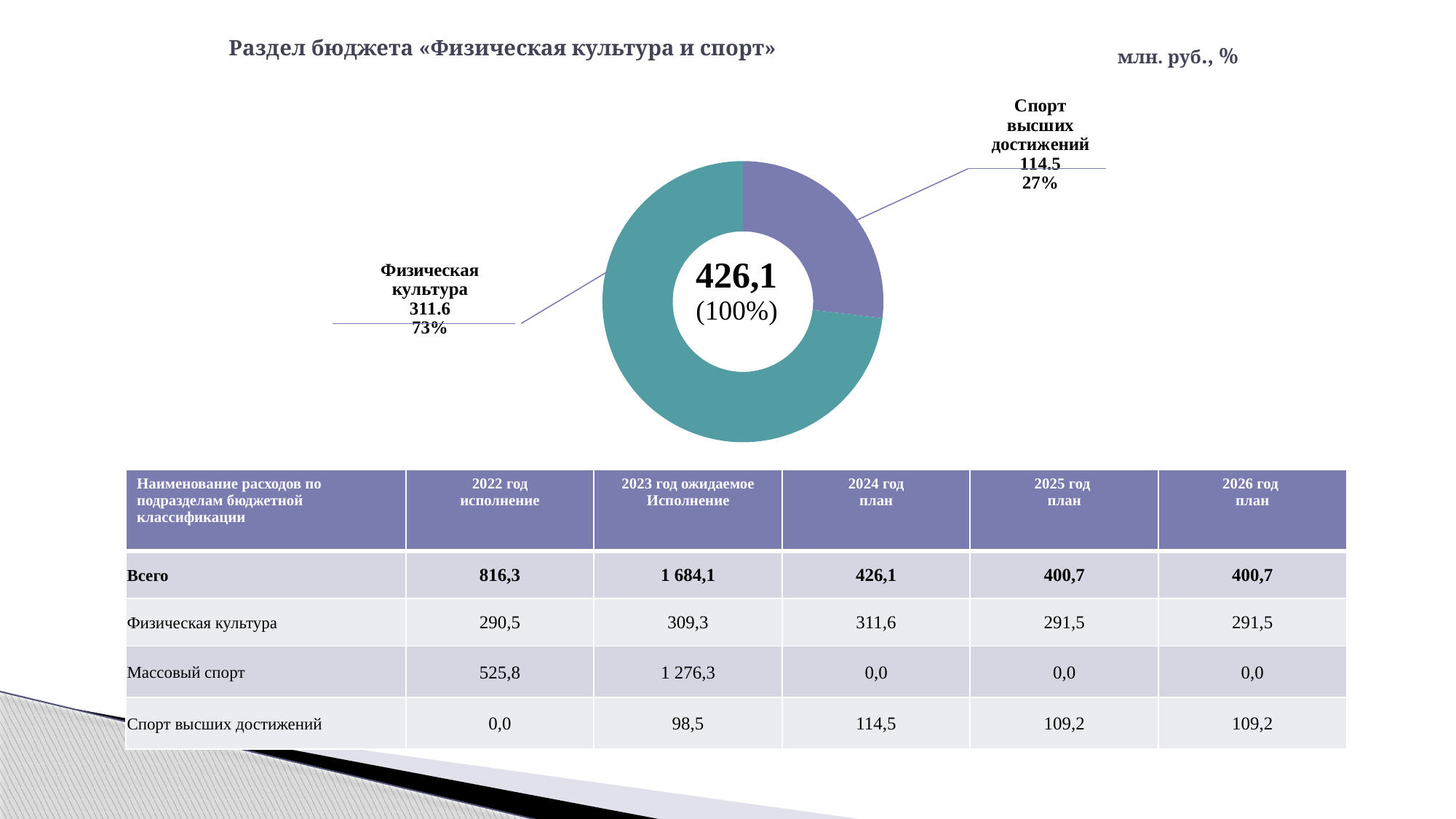
What share of the pie does Спорт высших достижений represent? 27% What is the value shown for Физическая культура in the pie chart? 311.6 What type of chart is shown on the slide? Pie chart (donut) Which slice of the pie chart is the largest? Физическая культура What units are indicated for the chart in the top right of the slide? млн. руб., % What total value is shown in the centre of the donut chart? 426,1 What is the value shown for Спорт высших достижений in the pie chart? 114.5 How many slices does the pie chart have? 2 What is the difference between the values for Физическая культура and Спорт высших достижений in the pie chart? 197.1 What share of the pie does Физическая культура represent? 73% Which slice of the pie chart is the smallest? Спорт высших достижений Which is larger in the pie chart: Физическая культура or Спорт высших достижений? Физическая культура